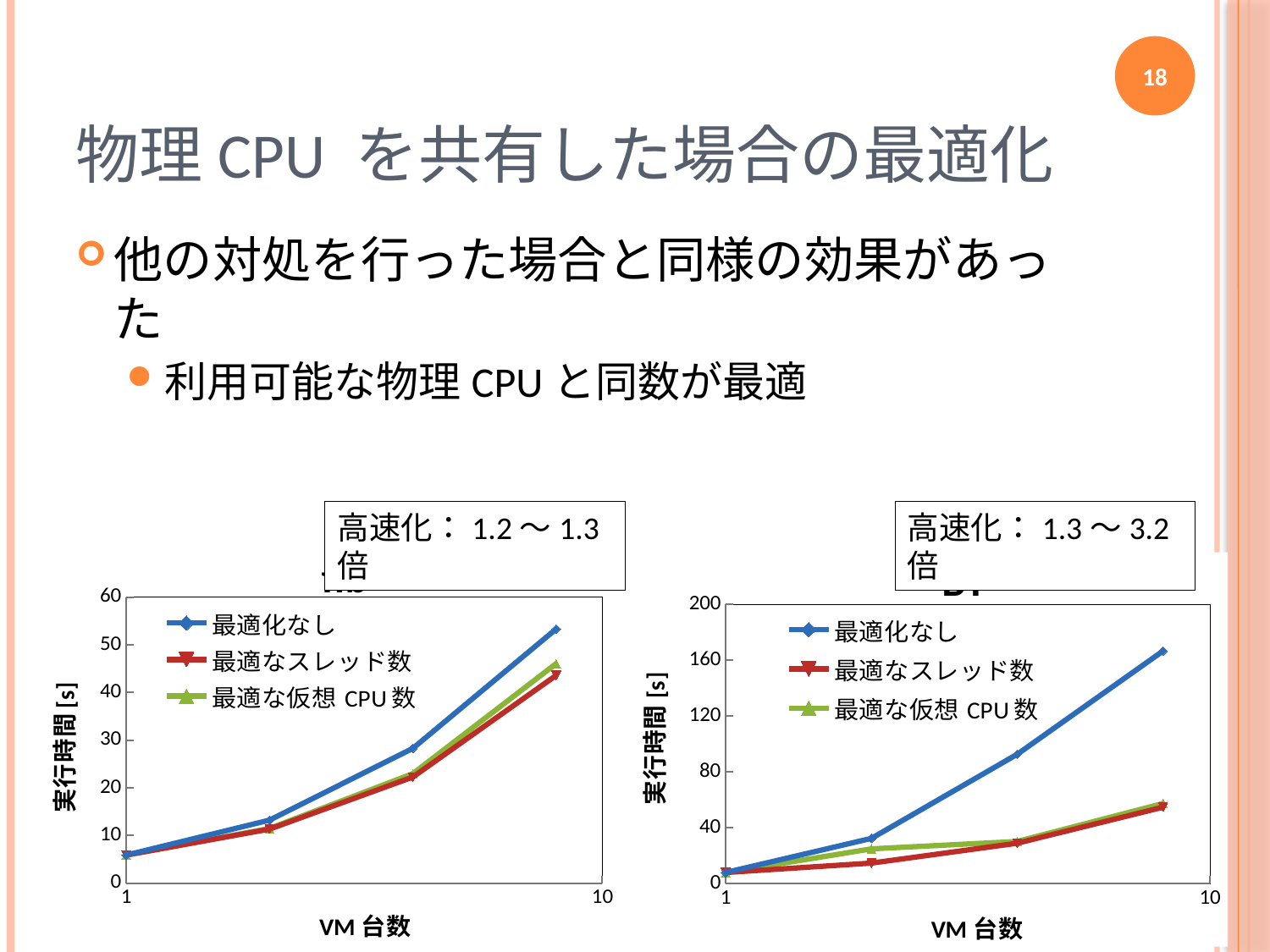
In the right chart, do the values of 最適化なし rise or fall as the number of VMs increases? rise What speedup range is stated in the annotation box above the right chart? 1.3 〜 3.2 倍 In the left chart, at the rightmost point (8 VMs), which is larger: 最適化なし or 最適なスレッド数? 最適化なし In the left chart, is the value for 最適化なし at the rightmost point (8 VMs) greater or less than 50? greater What is the y-axis label of the right chart? 実行時間 [s] In the right chart, which series has the highest value at the rightmost point (8 VMs)? 最適化なし What kind of chart is the left chart on the slide? line chart How many series does the legend of the right chart list? 3 In the right chart, is the value for 最適化なし at the rightmost point (8 VMs) greater or less than 120? greater In the right chart, is the value for 最適なスレッド数 at the rightmost point (8 VMs) greater or less than 80? less How many data points does each series in the left chart have? 4